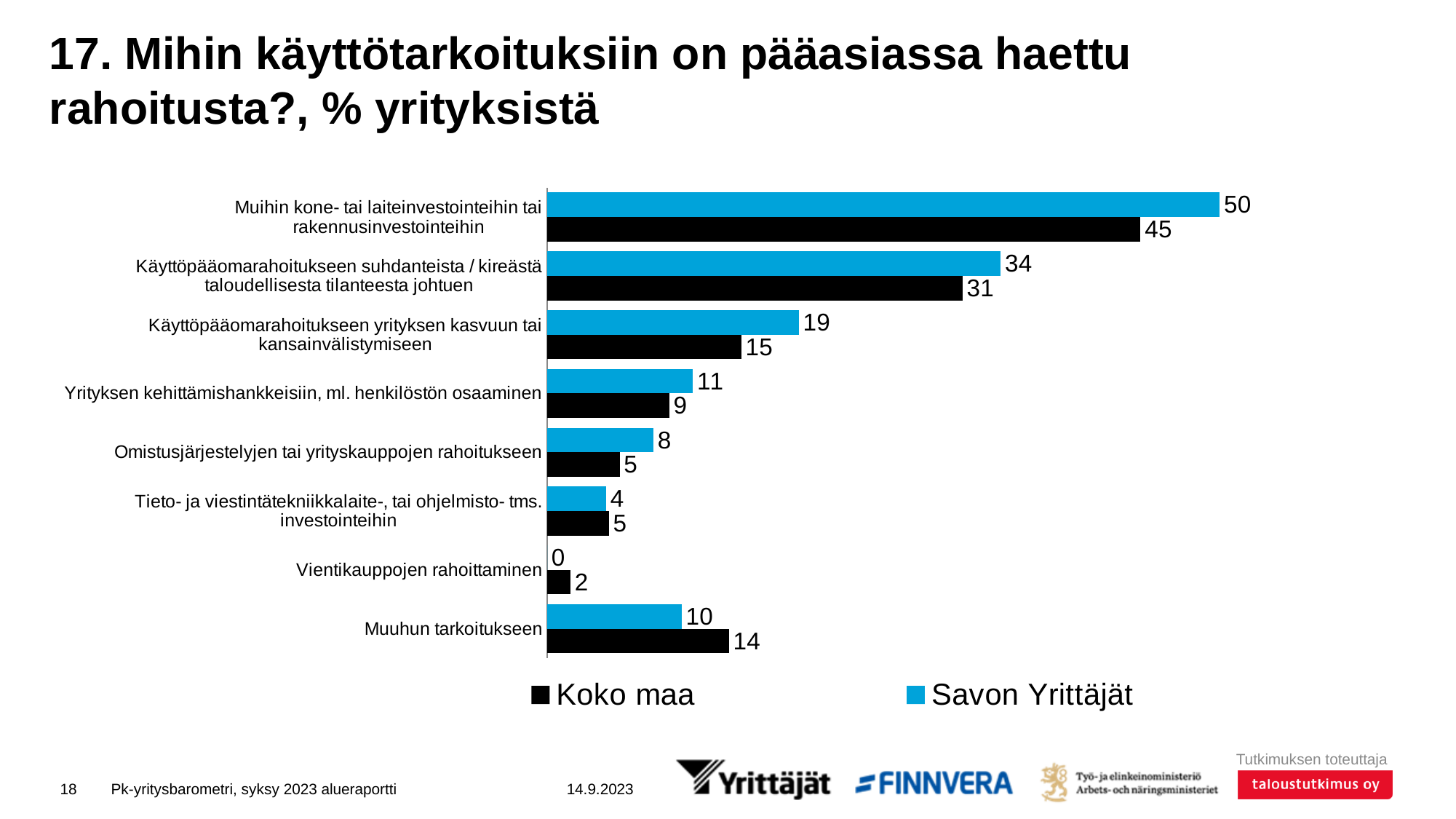
How many series does the legend list? 2 Which category has the lowest value for Koko maa? Vientikauppojen rahoittaminen Which category has the highest value for Savon Yrittäjät? Muihin kone- tai laiteinvestointeihin tai rakennusinvestointeihin What is the value for Koko maa for 'Muuhun tarkoitukseen'? 14 What is the value for Savon Yrittäjät for 'Vientikauppojen rahoittaminen'? 0 For 'Muuhun tarkoitukseen', which series has the larger value, Koko maa or Savon Yrittäjät? Koko maa What is the difference between Savon Yrittäjät and Koko maa for 'Käyttöpääomarahoitukseen yrityksen kasvuun tai kansainvälistymiseen'? 4 What is the value for Savon Yrittäjät for 'Muihin kone- tai laiteinvestointeihin tai rakennusinvestointeihin'? 50 What is the value for Koko maa for 'Käyttöpääomarahoitukseen suhdanteista / kireästä taloudellisesta tilanteesta johtuen'? 31 What kind of chart is shown on the slide? Bar chart How many categories are shown in the chart? 8 Which colour represents Savon Yrittäjät in the chart? Blue